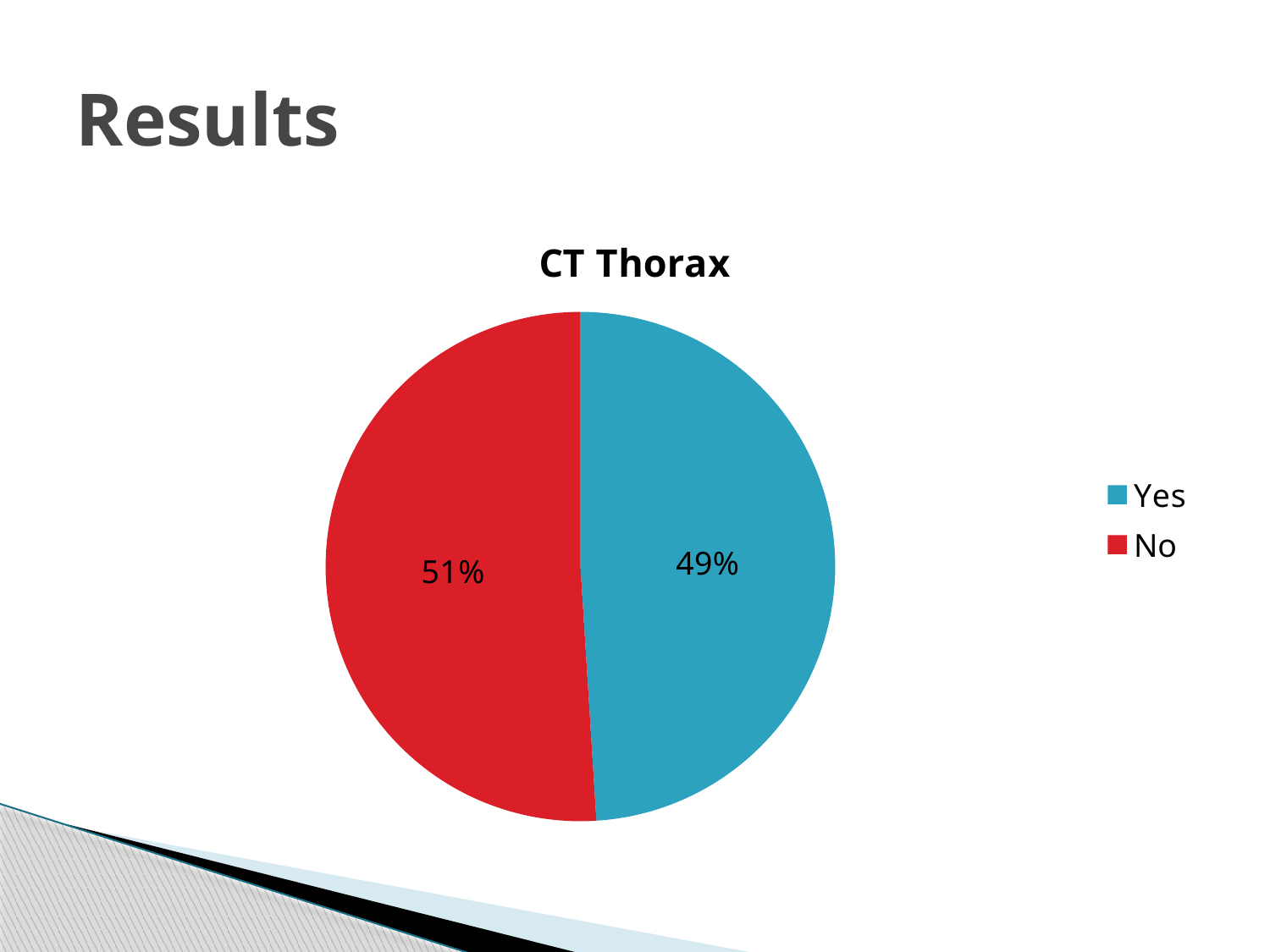
How many entries does the legend of the CT Thorax chart list? 2 What percentage of the CT Thorax pie chart is labelled Yes? 49% Is the Yes slice larger or smaller than the No slice in the CT Thorax chart? smaller What colour represents the Yes category in the CT Thorax chart? blue What share of the CT Thorax pie does the No slice represent? 51% How many slices does the CT Thorax pie chart have? 2 Which category has the larger share in the CT Thorax pie chart? No What is the difference in percentage points between the No and Yes slices in the CT Thorax chart? 2% What kind of chart is shown on the slide? pie chart What is the title of the chart on the slide? CT Thorax Which category has the smaller share in the CT Thorax pie chart? Yes What percentage of the CT Thorax pie chart is labelled No? 51%